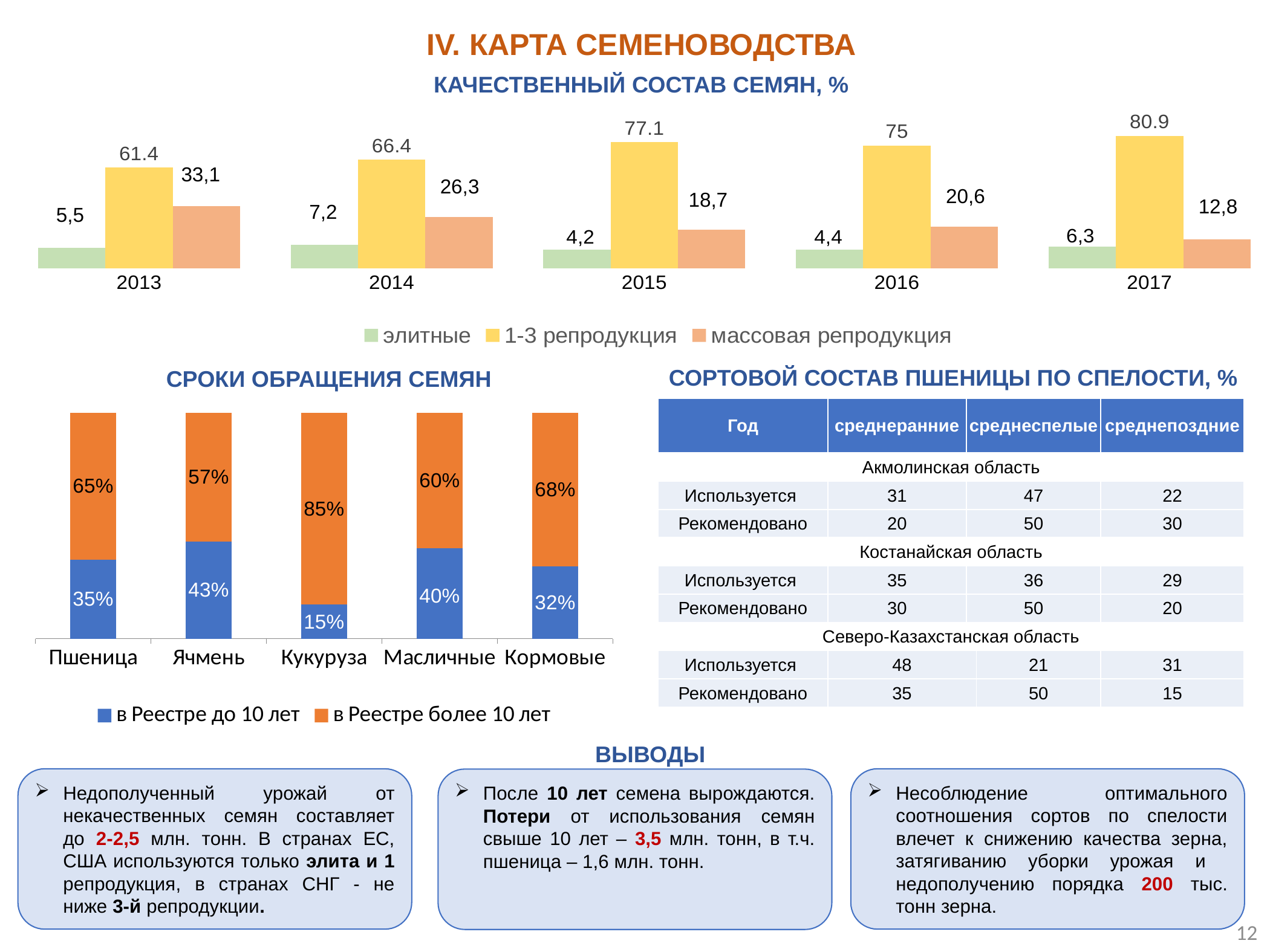
In the chart 'СРОКИ ОБРАЩЕНИЯ СЕМЯН', which has the larger value for 'в Реестре до 10 лет': Ячмень or Кормовые? Ячмень In the chart 'КАЧЕСТВЕННЫЙ СОСТАВ СЕМЯН, %', which year has the lowest value for 'элитные'? 2015 In the chart 'СРОКИ ОБРАЩЕНИЯ СЕМЯН', which category has the highest value for 'в Реестре более 10 лет'? Кукуруза In the chart 'КАЧЕСТВЕННЫЙ СОСТАВ СЕМЯН, %', what is the value for '1-3 репродукция' in 2017? 80.9 In the chart 'КАЧЕСТВЕННЫЙ СОСТАВ СЕМЯН, %', does the value for '1-3 репродукция' rise or fall from 2013 to 2017? rise In the chart 'СРОКИ ОБРАЩЕНИЯ СЕМЯН', what is the value for 'в Реестре до 10 лет' for Кукуруза? 15% In the chart 'КАЧЕСТВЕННЫЙ СОСТАВ СЕМЯН, %', which year has the highest value for 'массовая репродукция'? 2013 In the chart 'СРОКИ ОБРАЩЕНИЯ СЕМЯН', what is the difference between 'в Реестре более 10 лет' and 'в Реестре до 10 лет' for Пшеница? 30% How many years are shown on the x axis of the chart 'КАЧЕСТВЕННЫЙ СОСТАВ СЕМЯН, %'? 5 How many series does the legend of the chart 'КАЧЕСТВЕННЫЙ СОСТАВ СЕМЯН, %' list? 3 What kind of chart is 'СРОКИ ОБРАЩЕНИЯ СЕМЯН'? stacked bar chart In the chart 'КАЧЕСТВЕННЫЙ СОСТАВ СЕМЯН, %', what is the value for 'элитные' in 2014? 7,2